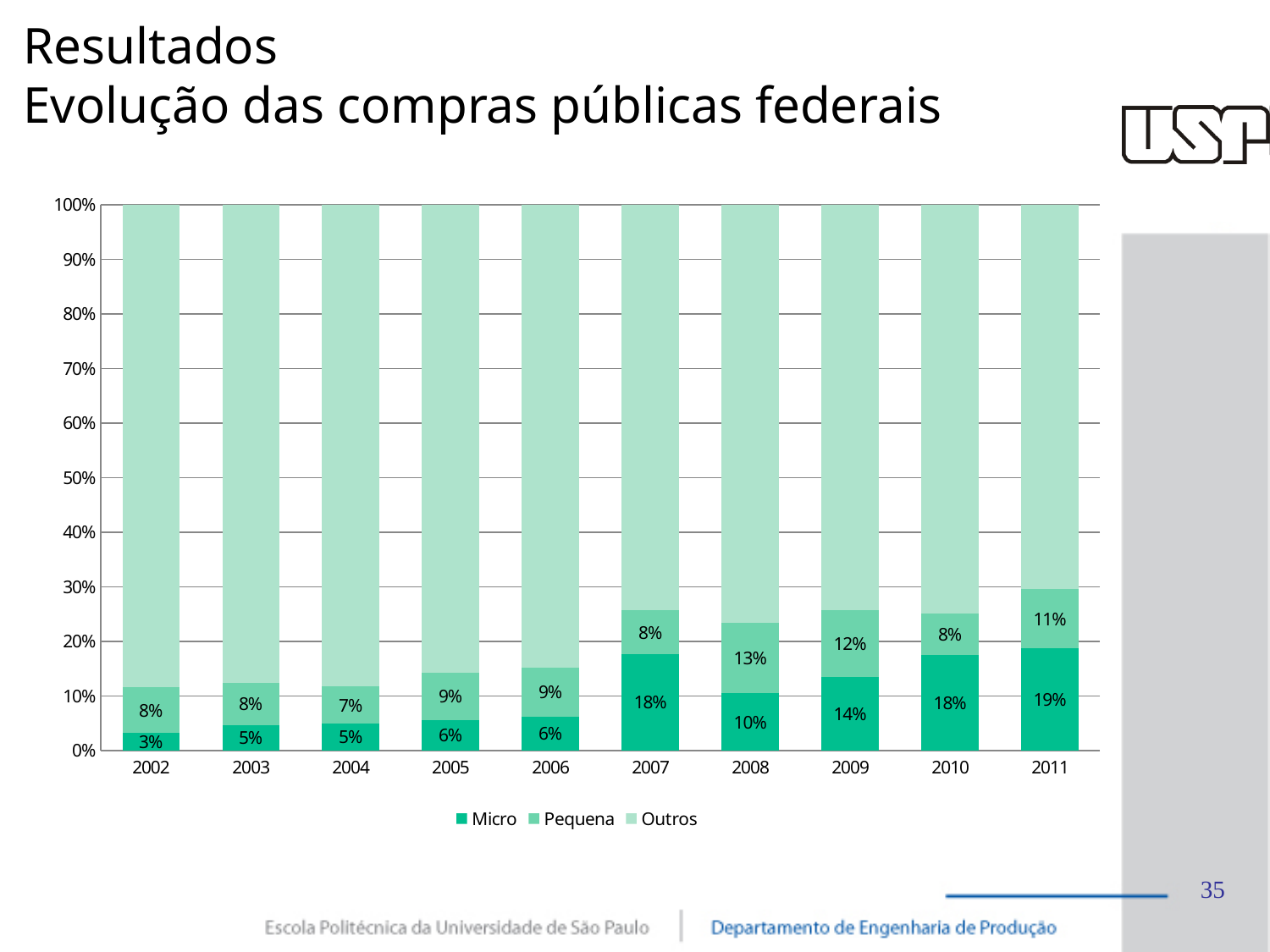
In which year is the Micro share lowest? 2002 How many series does the legend list? 3 In which year is the Micro share highest? 2011 What is the value for Micro in 2007? 18% What is the value for Pequena in 2008? 13% In which year is the Pequena share highest? 2008 How many years are shown on the x axis? 10 What is the value for Micro in 2011? 19% Is the value for Outros in 2011 greater or less than 60%? greater Which year has the larger Pequena value, 2008 or 2009? 2008 What kind of chart is shown on the slide? stacked bar chart What is the difference between the Micro value in 2011 and in 2002? 16%